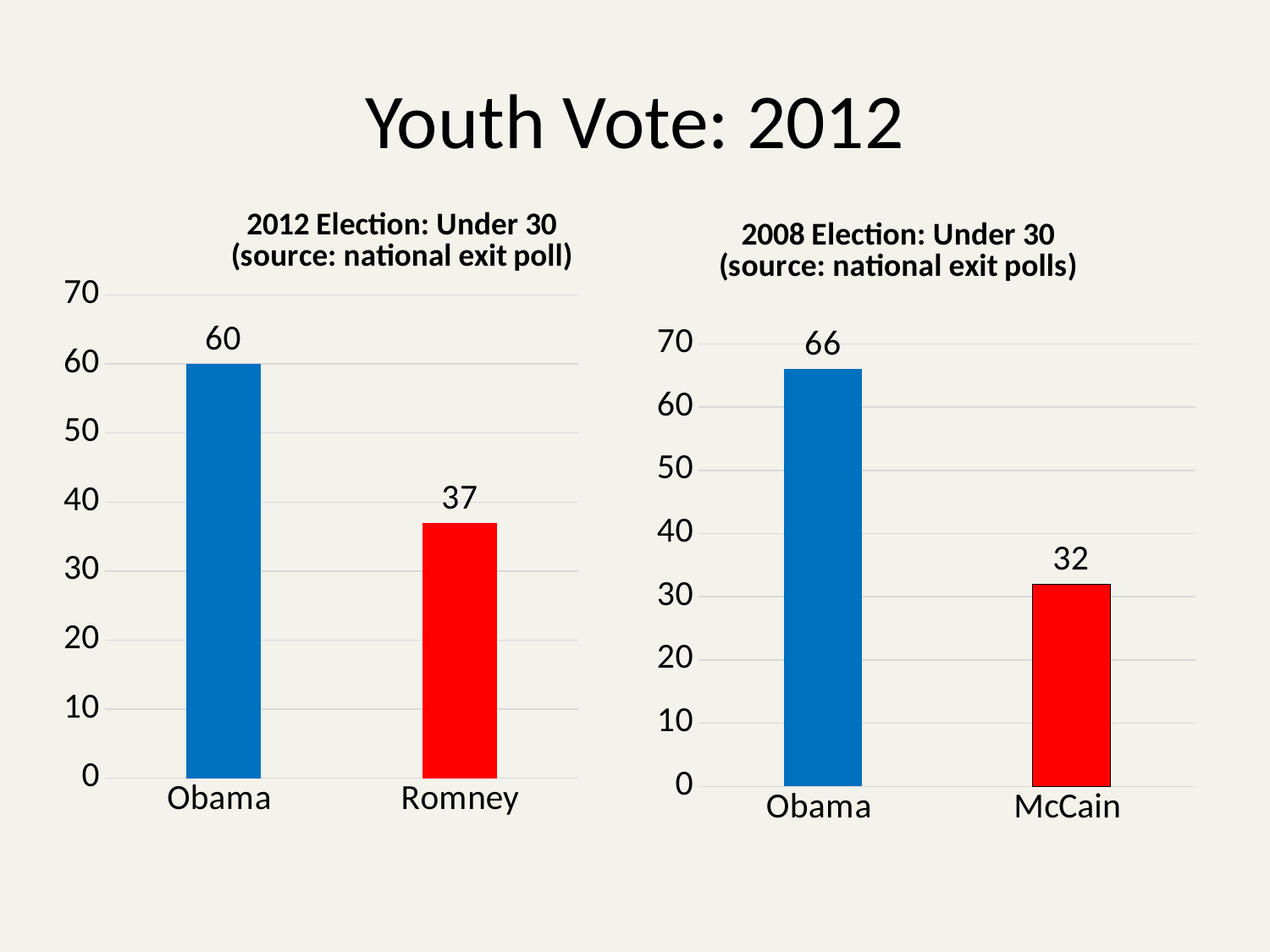
In the 2012 Election: Under 30 chart, which candidate has the highest value? Obama How many categories are shown in the 2008 Election: Under 30 chart? 2 In the 2012 Election: Under 30 chart, is the value for Romney greater or less than 40? less In the 2008 Election: Under 30 chart, which candidate has the lowest value? McCain In the 2012 Election: Under 30 chart, what is the difference between Obama's and Romney's values? 23 In the 2008 Election: Under 30 chart, what is the value for McCain? 32 In the 2012 Election: Under 30 chart, what is the value for Obama? 60 In the 2008 Election: Under 30 chart, what is the value for Obama? 66 In the 2008 Election: Under 30 chart, what is the difference between Obama's and McCain's values? 34 What type of chart is the 2012 Election: Under 30 chart? bar chart In the 2012 Election: Under 30 chart, what is the value for Romney? 37 Is Obama's value in the 2008 Election: Under 30 chart larger or smaller than his value in the 2012 Election: Under 30 chart? larger